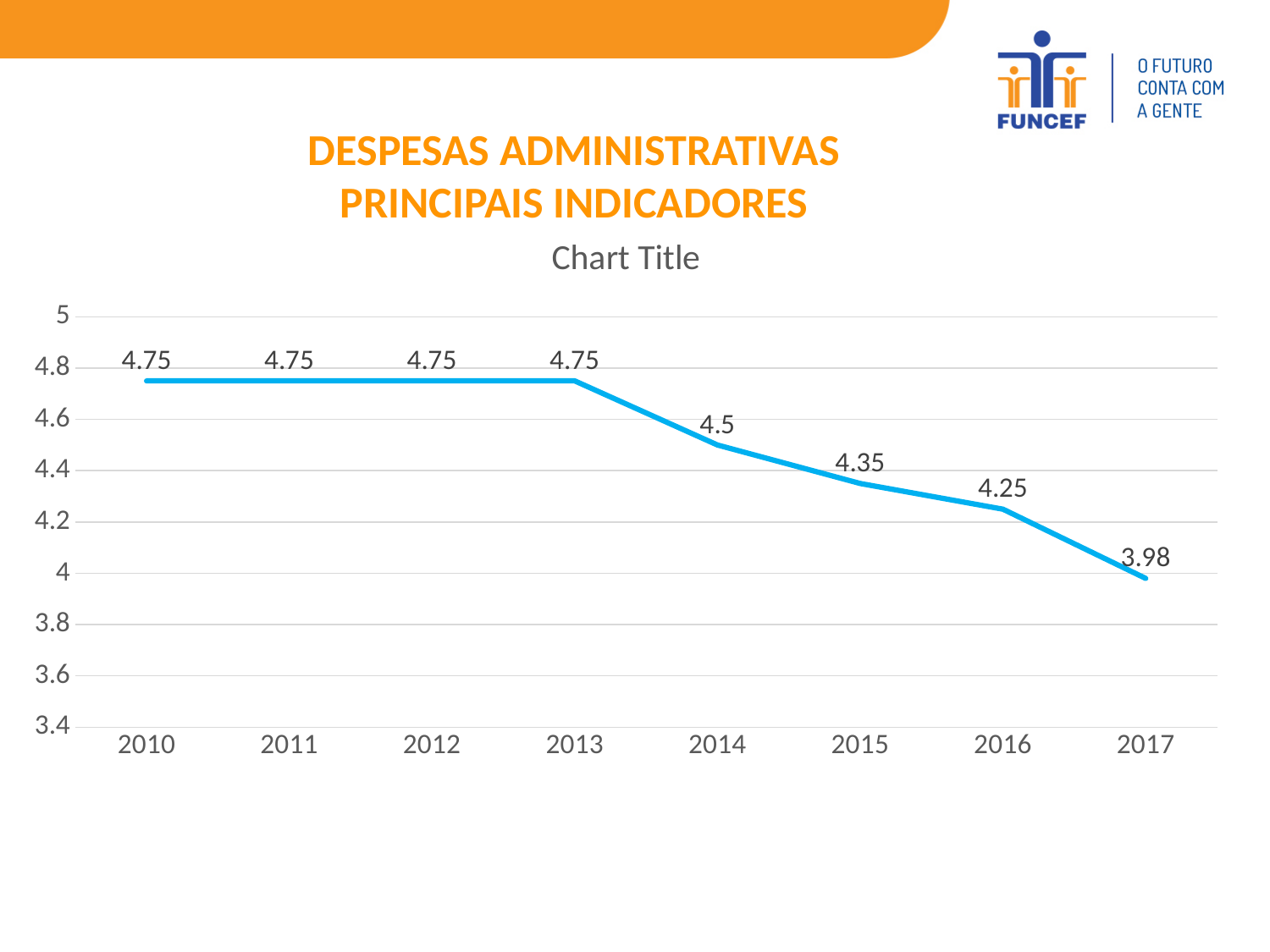
What is the value for 2014? 4.5 What kind of chart is shown? line chart What is the value for 2017? 3.98 What is the difference between the values for 2013 and 2014? 0.25 Which is larger, the value for 2015 or the value for 2016? 2015 What is the value for 2015? 4.35 Which year has the lowest value? 2017 What is the value for 2010? 4.75 What is the difference between the values for 2016 and 2017? 0.27 How many years are plotted on the x axis? 8 Is the value for 2017 greater or less than 4? less Do the values rise or fall from 2013 to 2017? fall